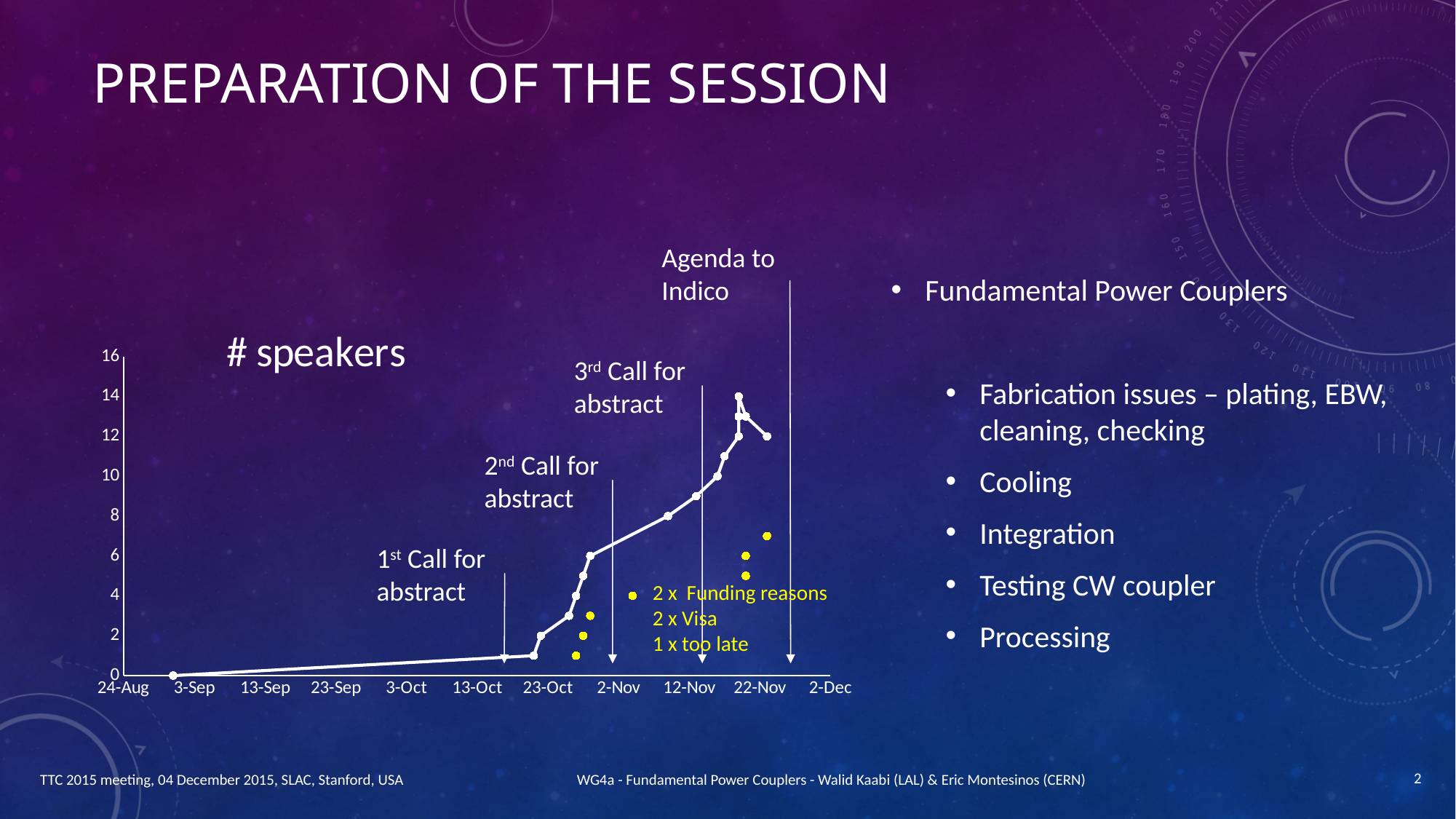
Is the peak number of speakers greater or less than 12? greater What is the title of the chart? # speakers What kind of chart is shown on the slide? line chart Is the number of speakers at 2-Nov greater or less than 4? greater What is the highest value shown on the y axis? 16 Which date has more speakers, 2-Nov or 12-Nov? 12-Nov Is the number of speakers at 13-Oct greater or less than 2? less Which date has more speakers, 23-Oct or 22-Nov? 22-Nov Does the number of speakers generally rise or fall from 24-Aug to 22-Nov? rise